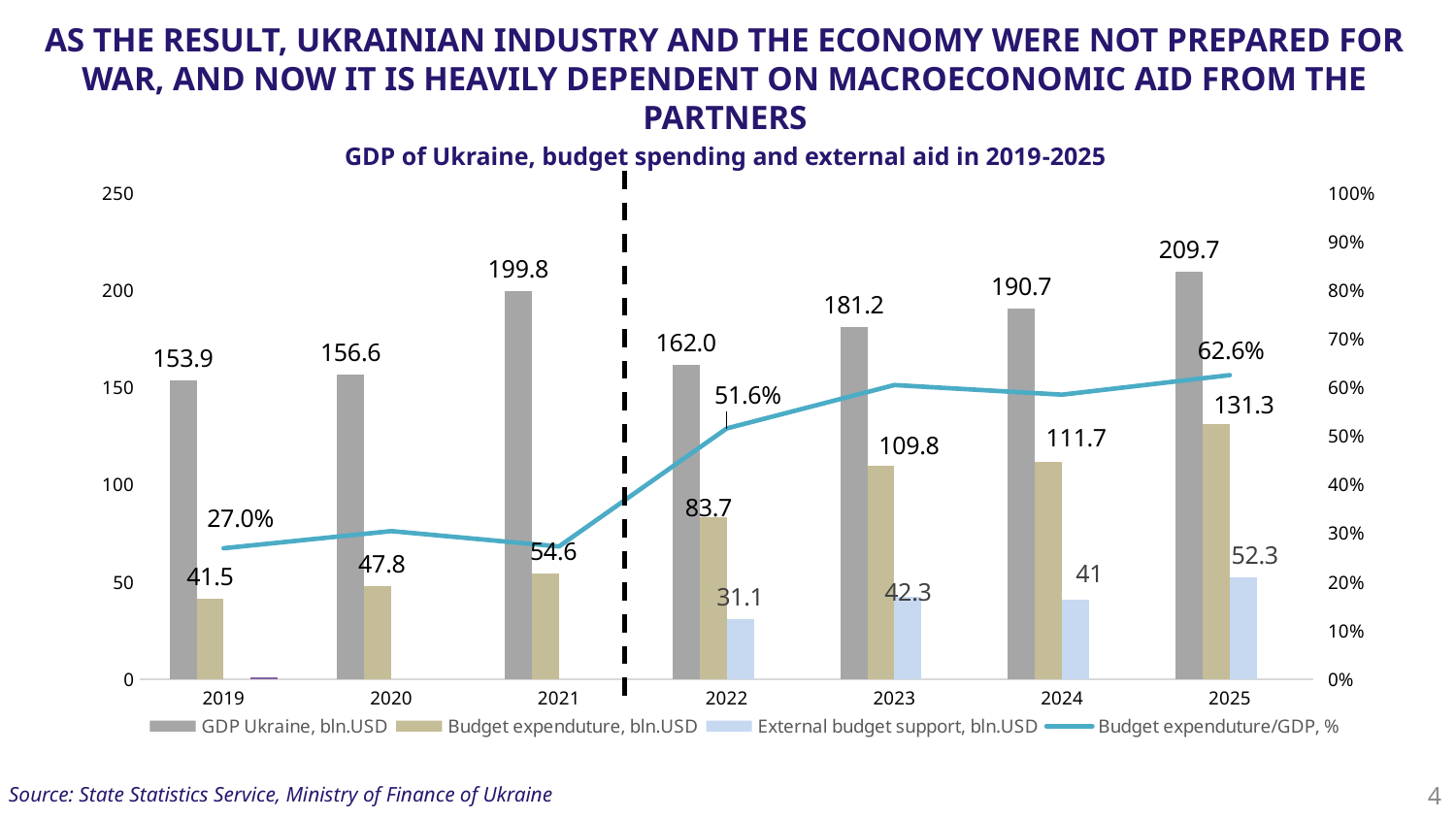
Which year has the larger External budget support, bln.USD: 2023 or 2024? 2023 In which year is GDP Ukraine, bln.USD the highest? 2025 How many series does the legend list? 4 How many years are shown on the x axis? 7 What is the value of Budget expenditure, bln.USD for 2023? 109.8 What is the difference between GDP Ukraine, bln.USD in 2025 and in 2019? 55.8 What is the value of GDP Ukraine, bln.USD for 2021? 199.8 In which year is GDP Ukraine, bln.USD the lowest? 2019 What is the value of Budget expenditure/GDP, % for 2025? 62.6% What is the value of External budget support, bln.USD for 2024? 41 Does Budget expenditure, bln.USD rise or fall from 2019 to 2025? rise Is the value of Budget expenditure/GDP, % for 2023 greater or less than 50%? greater